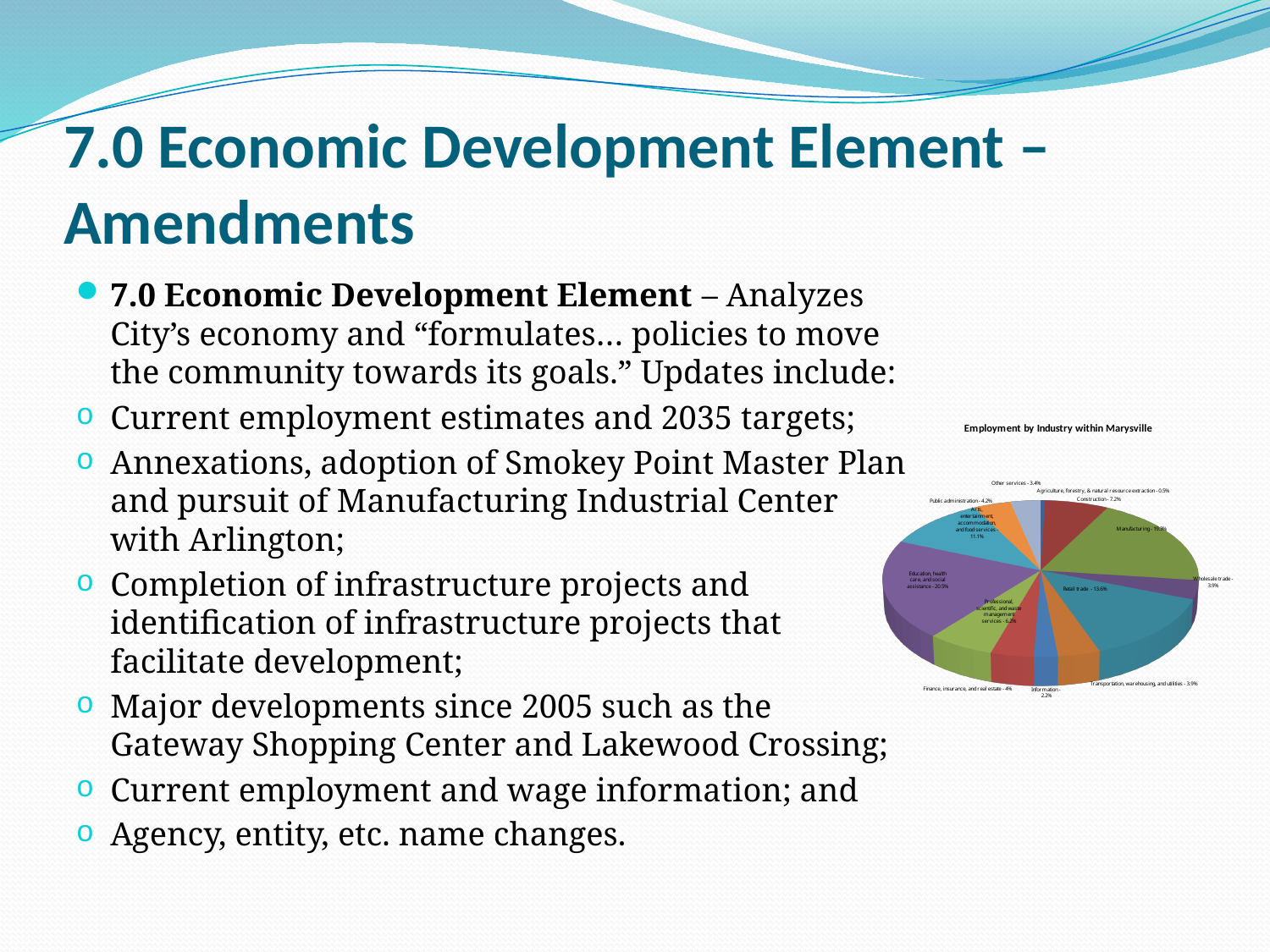
What share of employment is Construction in the pie chart? 7.2% What share of employment is Arts, entertainment, accommodation, and food services in the pie chart? 11.1% What share of employment is Public administration in the pie chart? 4.2% What kind of chart is shown on the slide? pie chart How many percentage points larger is the Retail trade share than the Construction share in the pie chart? 6.4% What share of employment is Information in the pie chart? 2.2% How many industry categories are shown in the pie chart? 13 Which has a larger share in the pie chart, Education, health care, and social assistance or Retail trade? Education, health care, and social assistance What is the title of the chart on the slide? Employment by Industry within Marysville What share of employment is Education, health care, and social assistance in the pie chart? 20.5% Which industry has the smallest share in the pie chart? Agriculture, forestry, & natural resource extraction What share of employment is Retail trade in the pie chart? 13.6%